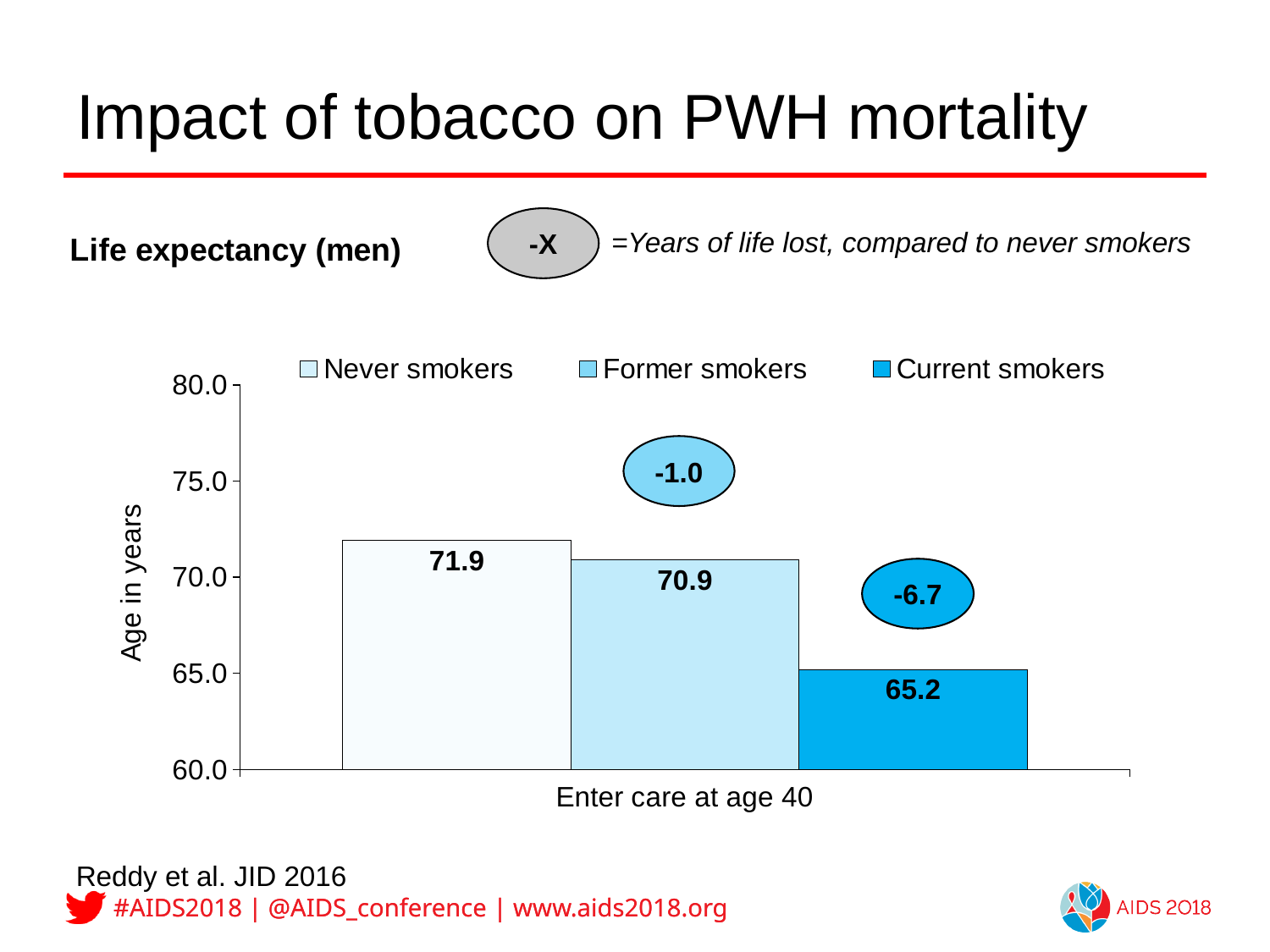
What is the life expectancy value shown for Never smokers? 71.9 How many series does the legend list? 3 What is the difference in life expectancy between Never smokers and Former smokers? 1.0 Which group has the highest life expectancy on the chart? Never smokers Which is larger, the value for Former smokers or the value for Current smokers? Former smokers What is the life expectancy value shown for Current smokers? 65.2 Which group has the lowest life expectancy on the chart? Current smokers Is the value for Current smokers greater or less than 70.0? less What is the life expectancy value shown for Former smokers? 70.9 What is the label on the y axis of the chart? Age in years What kind of chart is shown on the slide? Bar chart What is the difference in life expectancy between Never smokers and Current smokers? 6.7